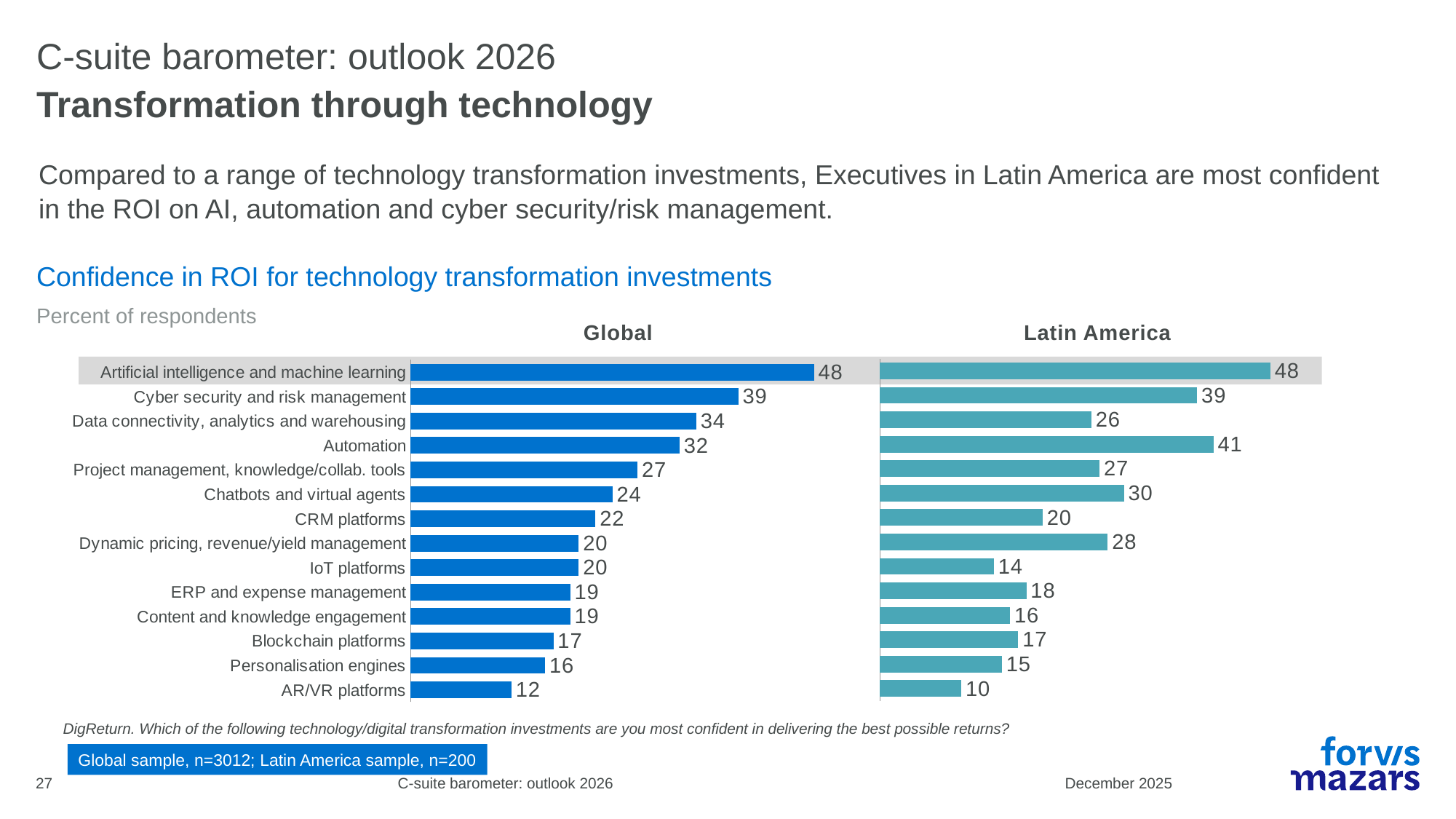
What kind of chart is used for the Global data? Bar chart In the Latin America chart, which category has the lowest value? AR/VR platforms How many categories are shown in the Global chart? 14 Which is larger: the Latin America value for Dynamic pricing, revenue/yield management or the Global value for the same category? Latin America What is the title of the chart section on the slide? Confidence in ROI for technology transformation investments In the Latin America chart, what is the value for Chatbots and virtual agents? 30 What is the difference between the Latin America and Global values for Data connectivity, analytics and warehousing? 8 In the Global chart, which category has the highest value? Artificial intelligence and machine learning What is the difference between the Global values for Cyber security and risk management and Blockchain platforms? 22 In the Global chart, what is the value for Automation? 32 In the Global chart, what is the value for AR/VR platforms? 12 In the Latin America chart, what is the value for Automation? 41